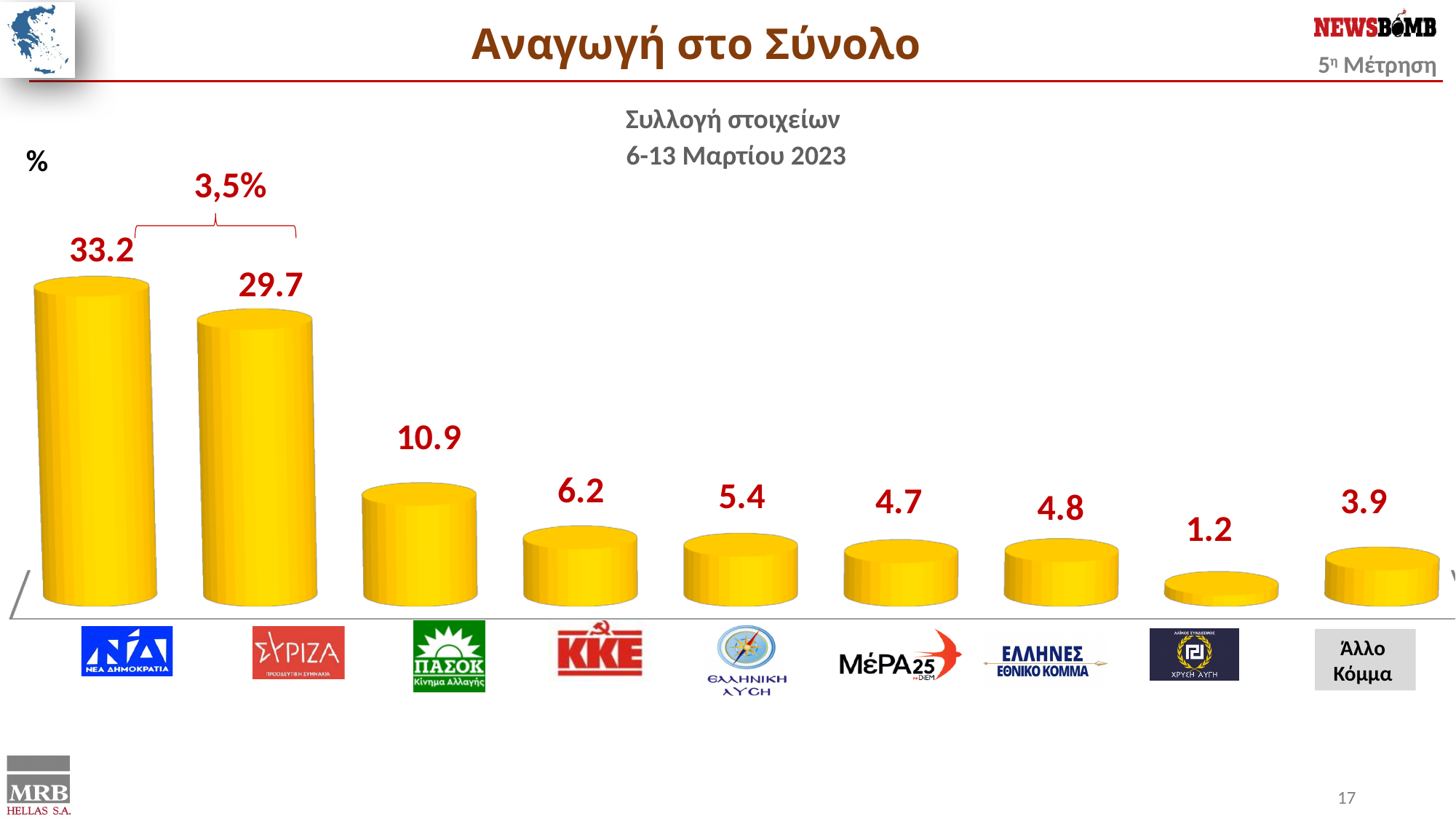
What kind of chart is shown on the slide? Bar chart What is the value shown for ΝΕΑ ΔΗΜΟΚΡΑΤΙΑ? 33.2 What is the difference between the values for ΝΕΑ ΔΗΜΟΚΡΑΤΙΑ and ΣΥΡΙΖΑ, as annotated on the chart? 3,5% What is the value shown for ΣΥΡΙΖΑ? 29.7 How many categories (bars) are shown on the chart? 9 What is the title of the slide? Αναγωγή στο Σύνολο What is the value shown for ΧΡΥΣΗ ΑΥΓΗ? 1.2 What is the value shown for ΚΚΕ? 6.2 What is the value shown for ΠΑΣΟΚ? 10.9 Which party has the highest value on the chart? ΝΕΑ ΔΗΜΟΚΡΑΤΙΑ Which is larger, the value for ΚΚΕ or the value for ΕΛΛΗΝΙΚΗ ΛΥΣΗ? ΚΚΕ Which category has the lowest value on the chart? ΧΡΥΣΗ ΑΥΓΗ